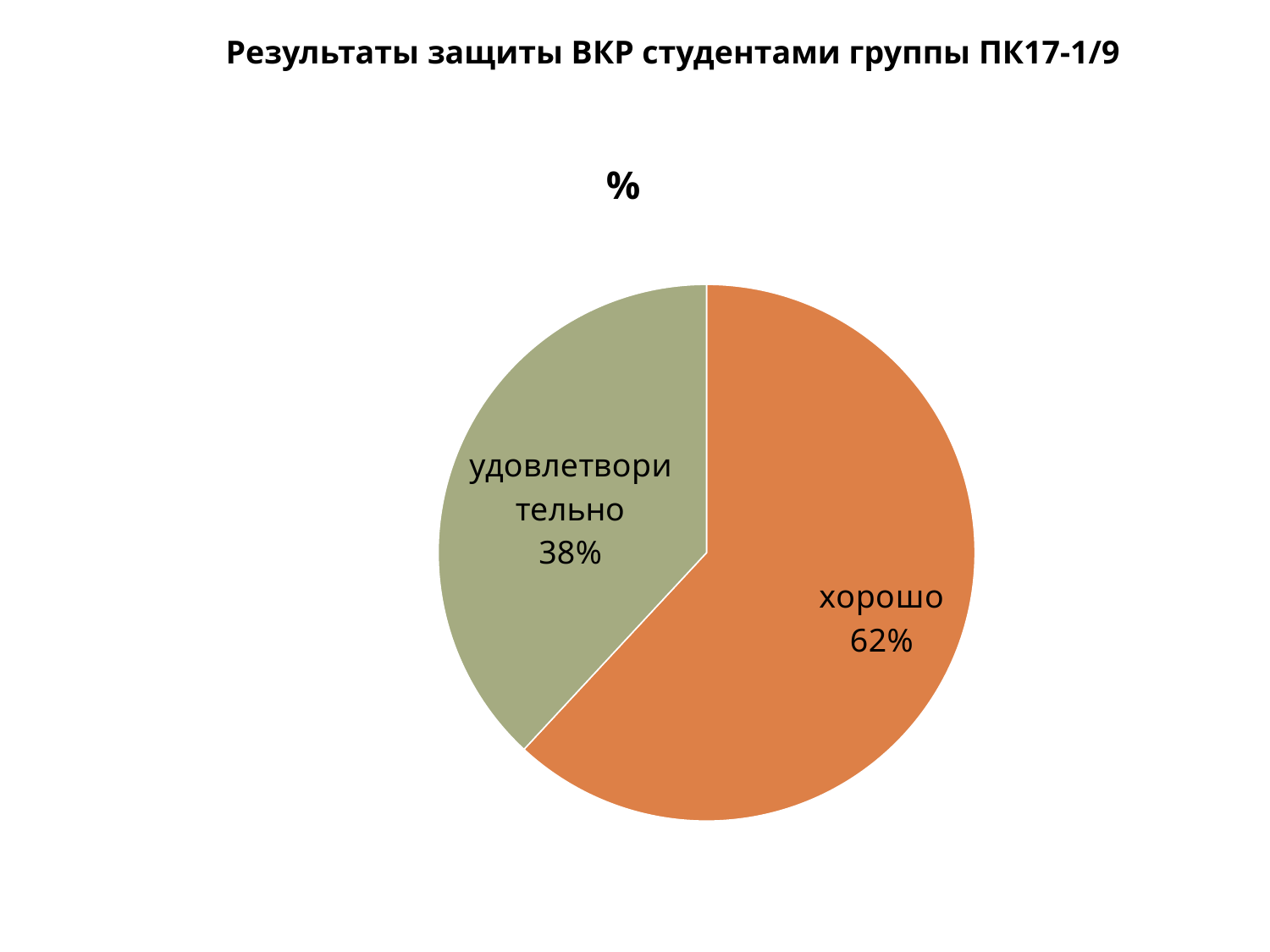
Which slice is larger, "хорошо" or "удовлетворительно"? хорошо Which category has the largest slice of the pie? хорошо What colour is the "хорошо" slice? orange What is the difference in percentage points between the "хорошо" and "удовлетворительно" slices? 24 How many slices does the pie chart have? 2 What is the title of the chart? % What share of the pie does the "хорошо" slice represent? 62% What kind of chart is shown on the slide? pie chart Which category has the smallest slice of the pie? удовлетворительно What share of the pie does the "удовлетворительно" slice represent? 38%